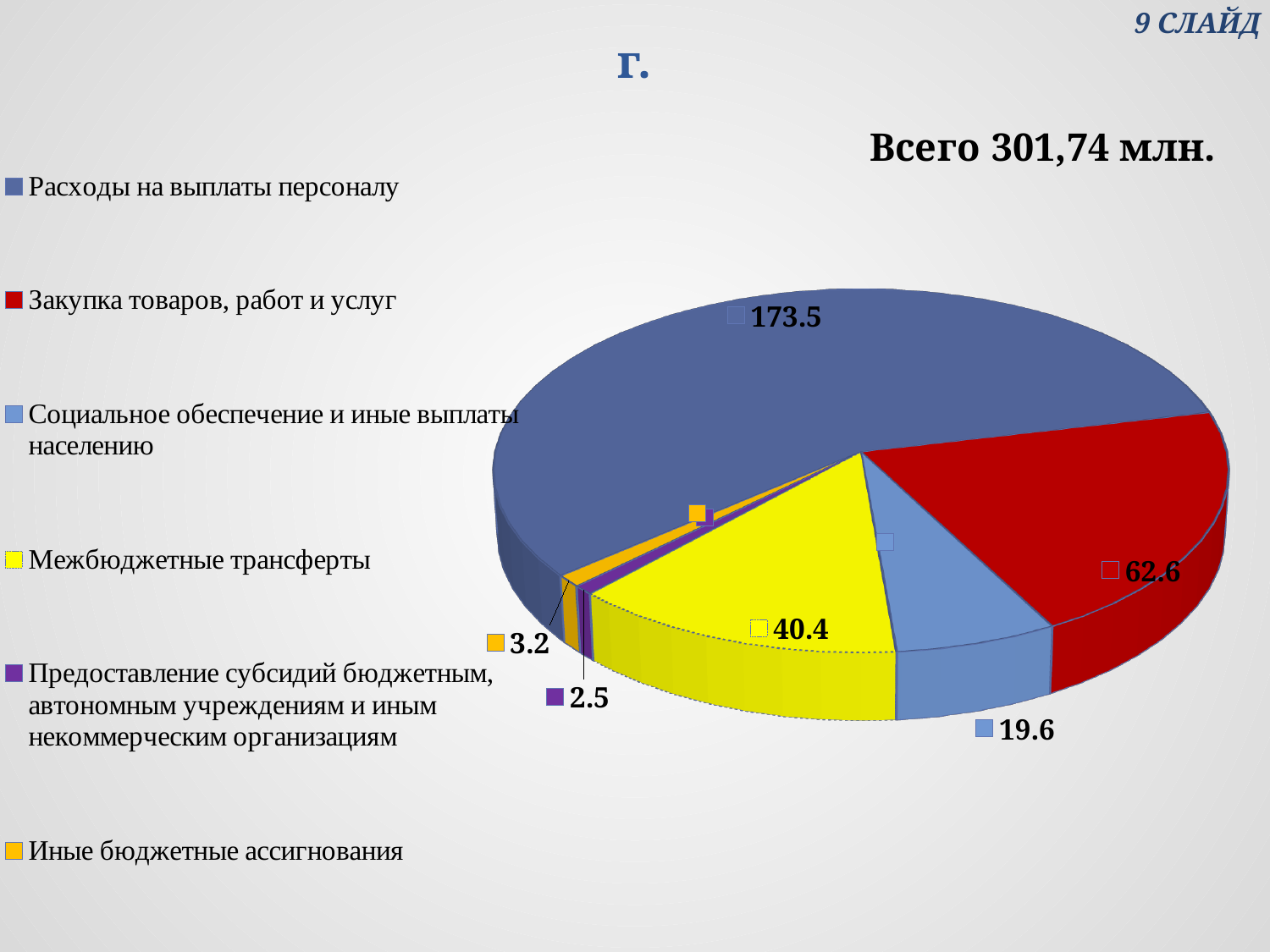
Which is larger, the value for Закупка товаров, работ и услуг or the value for Межбюджетные трансферты? Закупка товаров, работ и услуг What is the value for Закупка товаров, работ и услуг? 62.6 How many categories does the pie chart show? 6 What is the value for Межбюджетные трансферты? 40.4 What kind of chart is shown on the slide? Pie chart Which category has the smallest slice of the pie? Предоставление субсидий бюджетным, автономным учреждениям и иным некоммерческим организациям What is the difference between the values for Межбюджетные трансферты and Социальное обеспечение и иные выплаты населению? 20.8 What is the value for Расходы на выплаты персоналу? 173.5 What is the value for Социальное обеспечение и иные выплаты населению? 19.6 What is the difference between the values for Расходы на выплаты персоналу and Закупка товаров, работ и услуг? 110.9 What is the value for Иные бюджетные ассигнования? 3.2 Which category has the largest slice of the pie? Расходы на выплаты персоналу